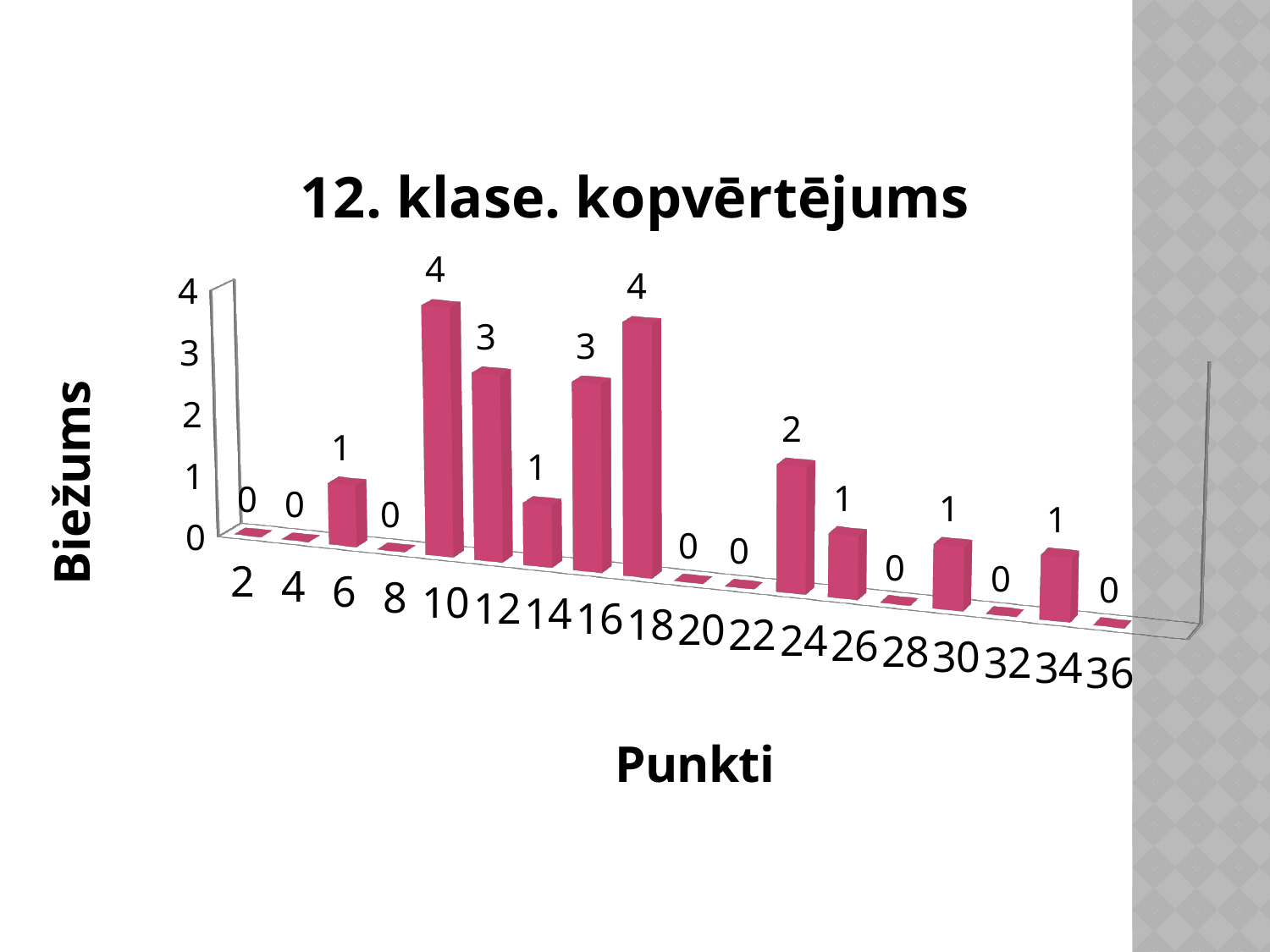
What is the difference between the values for 12 points and 14 points? 2 Which has a larger value, 30 points or 10 points? 10 What is the value for 10 points (Punkti) in the chart? 4 What is the value for 6 points in the chart? 1 What is the title of the chart? 12. klase. kopvērtējums What is the value for 20 points in the chart? 0 What is the value for 12 points in the chart? 3 What is the difference between the values for 18 points and 24 points? 2 What kind of chart is shown on the slide? Bar chart Which has a larger value, 16 points or 26 points? 16 What is the value for 24 points in the chart? 2 How many categories are shown on the x axis of the chart? 18